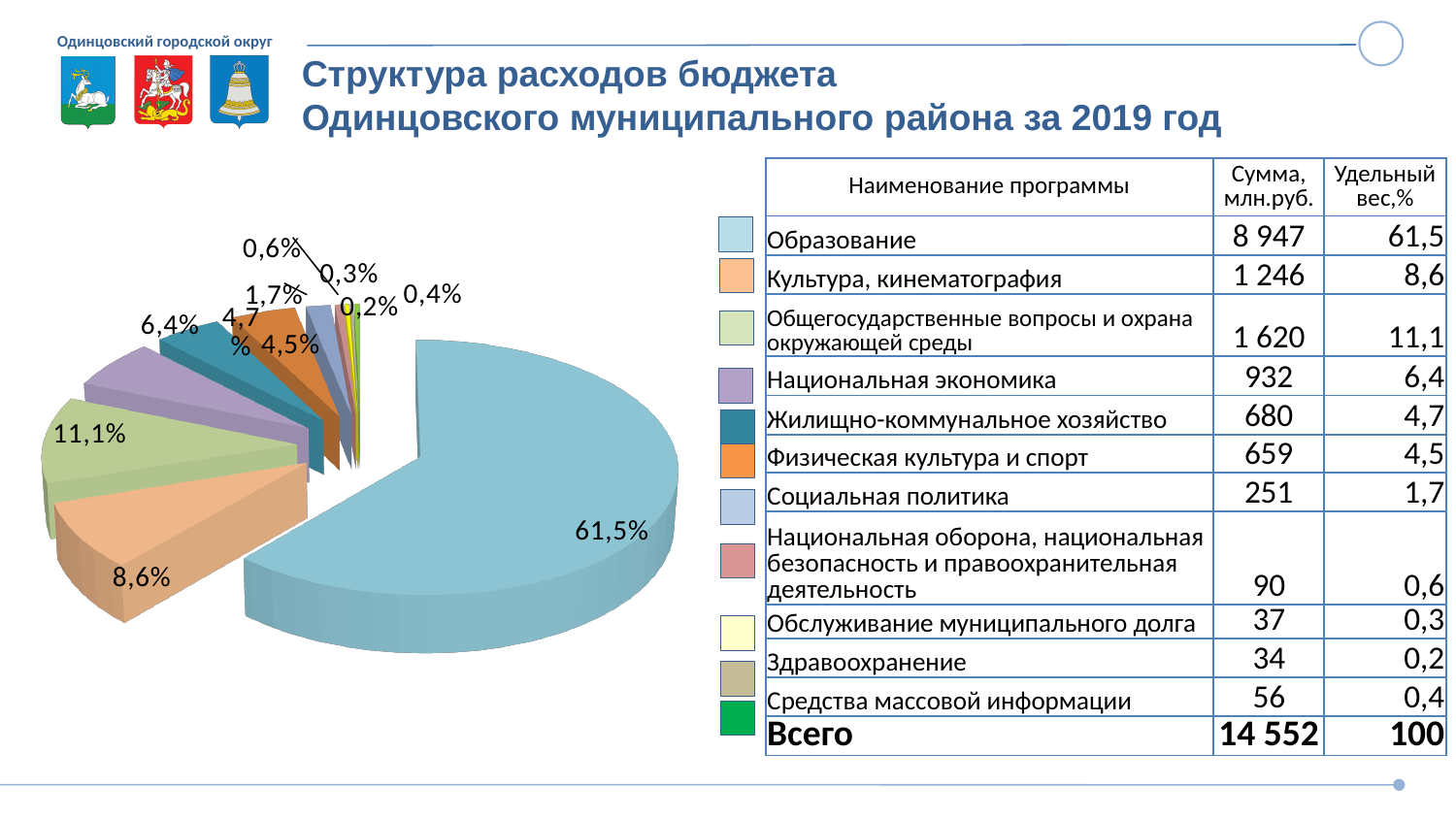
What kind of chart is shown on the slide? pie chart What share of the pie does Образование take? 61,5% What is the percentage label on the slice for Культура, кинематография? 8,6% What is the title of the slide containing the pie chart? Структура расходов бюджета Одинцовского муниципального района за 2019 год What is the percentage label on the slice for Социальная политика? 1,7% What is the percentage label on the slice for Национальная экономика? 6,4% Which category has the largest slice of the pie chart? Образование How many slices does the pie chart have? 11 Which category has the smallest slice of the pie chart? Здравоохранение What is the difference in percentage points between the Образование slice (61,5%) and the Общегосударственные вопросы и охрана окружающей среды slice (11,1%)? 50,4 Which slice is larger: Национальная экономика or Жилищно-коммунальное хозяйство? Национальная экономика What is the percentage label on the slice for Общегосударственные вопросы и охрана окружающей среды? 11,1%